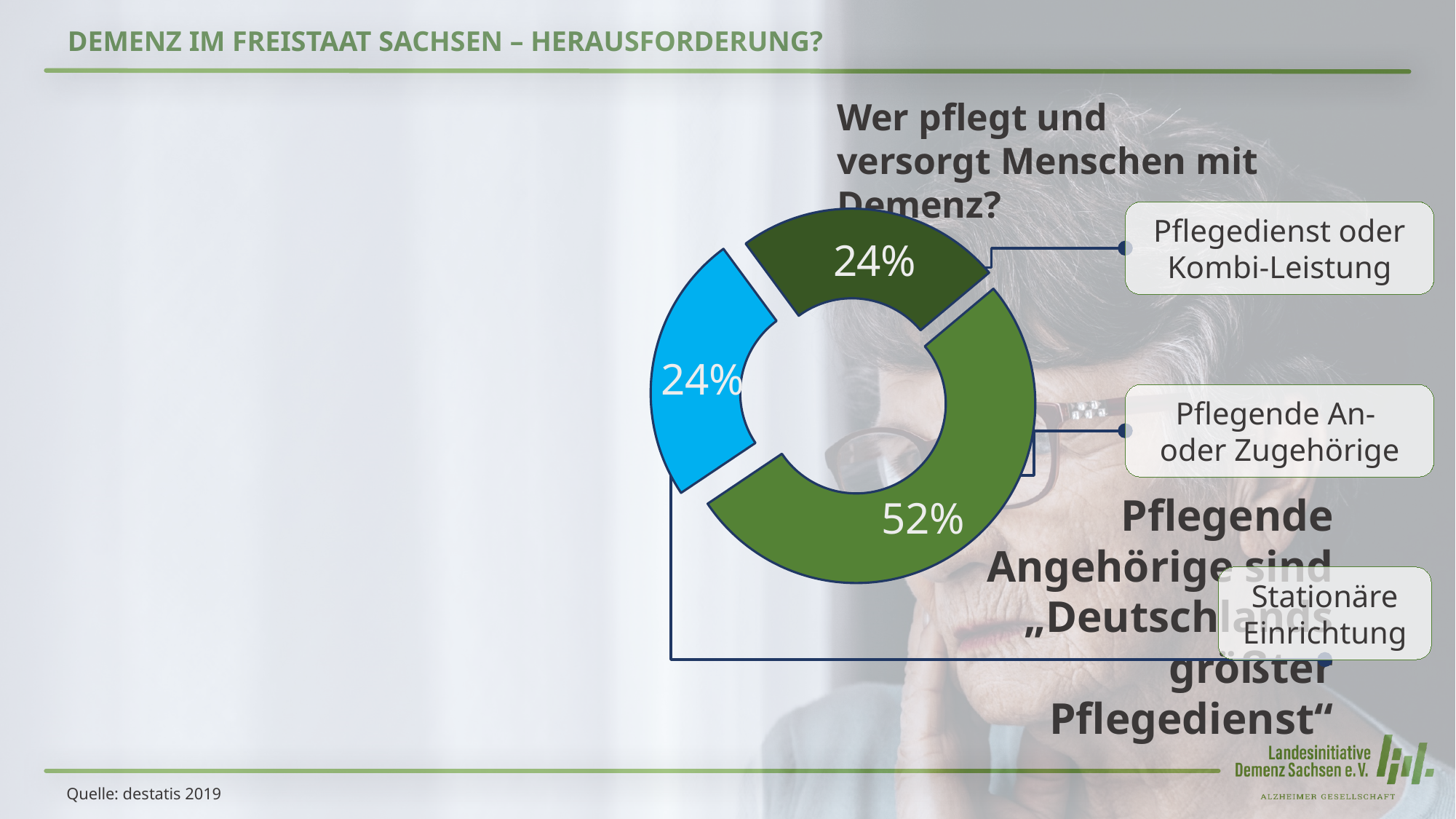
Which category has the largest share of the chart? Pflegende An- oder Zugehörige What is the difference in percentage points between the share for "Pflegende An- oder Zugehörige" and the share for "Stationäre Einrichtung"? 28 percentage points How many slices does the chart have? 3 Do the slices for "Pflegedienst oder Kombi-Leistung" and "Stationäre Einrichtung" have the same share? Yes, both 24% What is the combined share of "Pflegedienst oder Kombi-Leistung" and "Stationäre Einrichtung"? 48% What share of the chart is labelled "Pflegende An- oder Zugehörige"? 52% What colour is the slice for "Stationäre Einrichtung"? Light blue What share of the chart is labelled "Stationäre Einrichtung"? 24% What question is posed as the title above the chart? Wer pflegt und versorgt Menschen mit Demenz? What share of the chart is labelled "Pflegedienst oder Kombi-Leistung"? 24% Which is larger: the share for "Pflegende An- oder Zugehörige" or the share for "Pflegedienst oder Kombi-Leistung"? Pflegende An- oder Zugehörige What kind of chart is shown on the slide? Donut (pie) chart